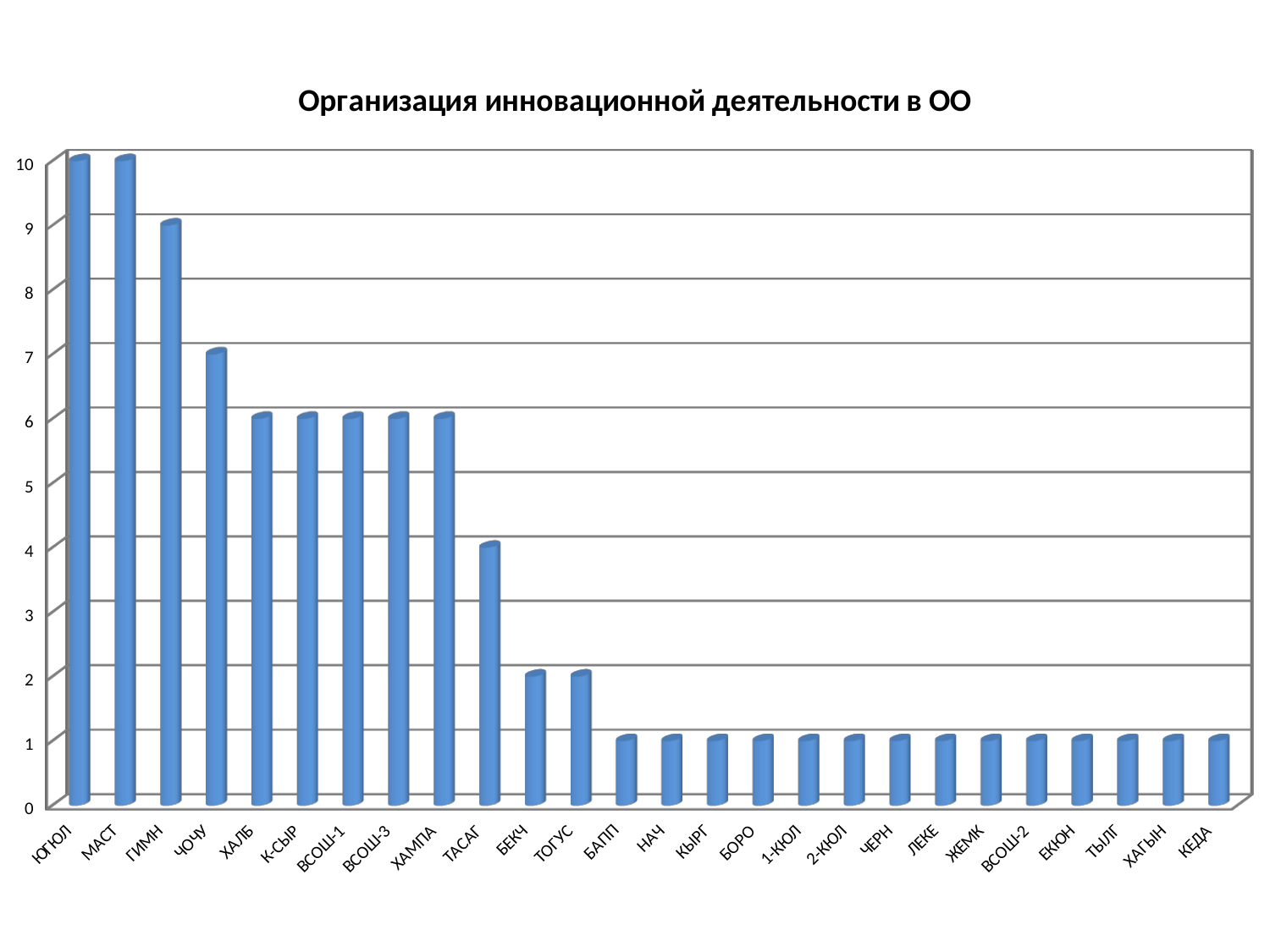
What is the difference between the values for ГИМН and ТАСАГ? 5 What is the value for ТАСАГ? 4 What is the value for ХАМПА? 6 What is the title of the chart? Организация инновационной деятельности в ОО What is the value for ЧОЧУ? 7 Do the values rise or fall from left to right along the x axis? fall What is the value for ГИМН? 9 Which is larger, the value for ЧОЧУ or the value for ХАЛБ? ЧОЧУ What kind of chart is shown on the slide? bar chart What is the value for БЕКЧ? 2 Is the value for ТАСАГ greater or less than 5? less How many categories are shown on the x axis? 26